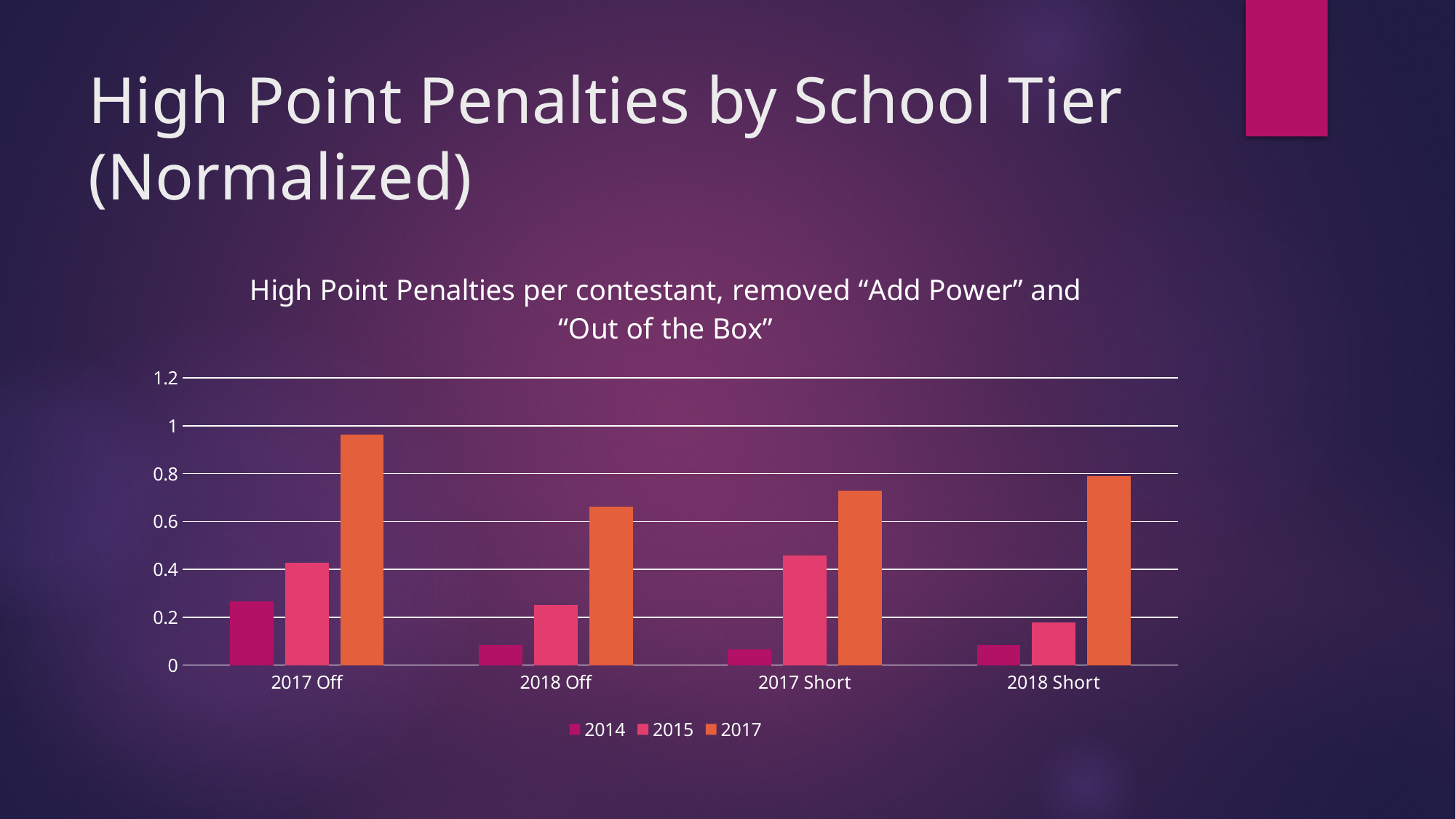
What kind of chart is shown on the slide? bar chart How many series does the legend list? 3 How many categories are shown on the x axis? 4 Is the 2017 series value for 2018 Short greater or less than 0.6? greater Which category has the highest value for the 2017 series? 2017 Off Which category has the highest value for the 2014 series? 2017 Off Which category has the lowest value for the 2017 series? 2018 Off Which is larger: the 2015 series value for 2017 Off or for 2018 Off? 2017 Off What is the title of the chart? High Point Penalties per contestant, removed “Add Power” and “Out of the Box” Which category has the lowest value for the 2015 series? 2018 Short Is the 2015 series value for 2018 Short greater or less than 0.2? less Is the 2017 series value for 2017 Off greater or less than 0.8? greater